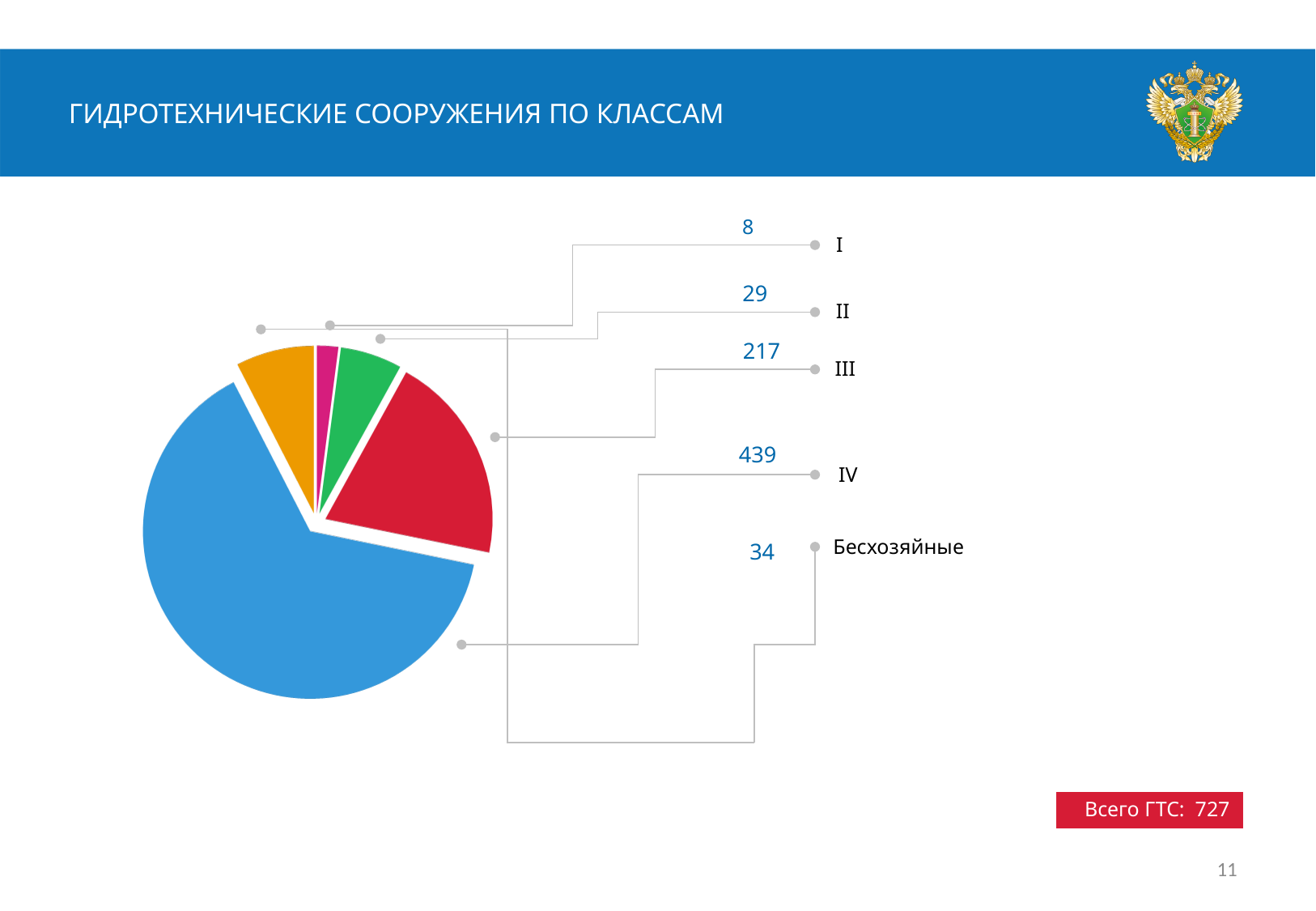
Which category has the smallest slice of the pie? I Which category has the largest slice of the pie? IV What is the value for Бесхозяйные? 34 What is the value for class I? 8 How many categories does the pie chart have? 5 What is the value for class III? 217 What total number of ГТС is stated on the slide? 727 What is the value for class IV? 439 Which is larger, the value for class II or the value for Бесхозяйные? Бесхозяйные What is the title of the slide? ГИДРОТЕХНИЧЕСКИЕ СООРУЖЕНИЯ ПО КЛАССАМ What kind of chart is shown on the slide? pie chart What is the difference between the values for class IV and class III? 222